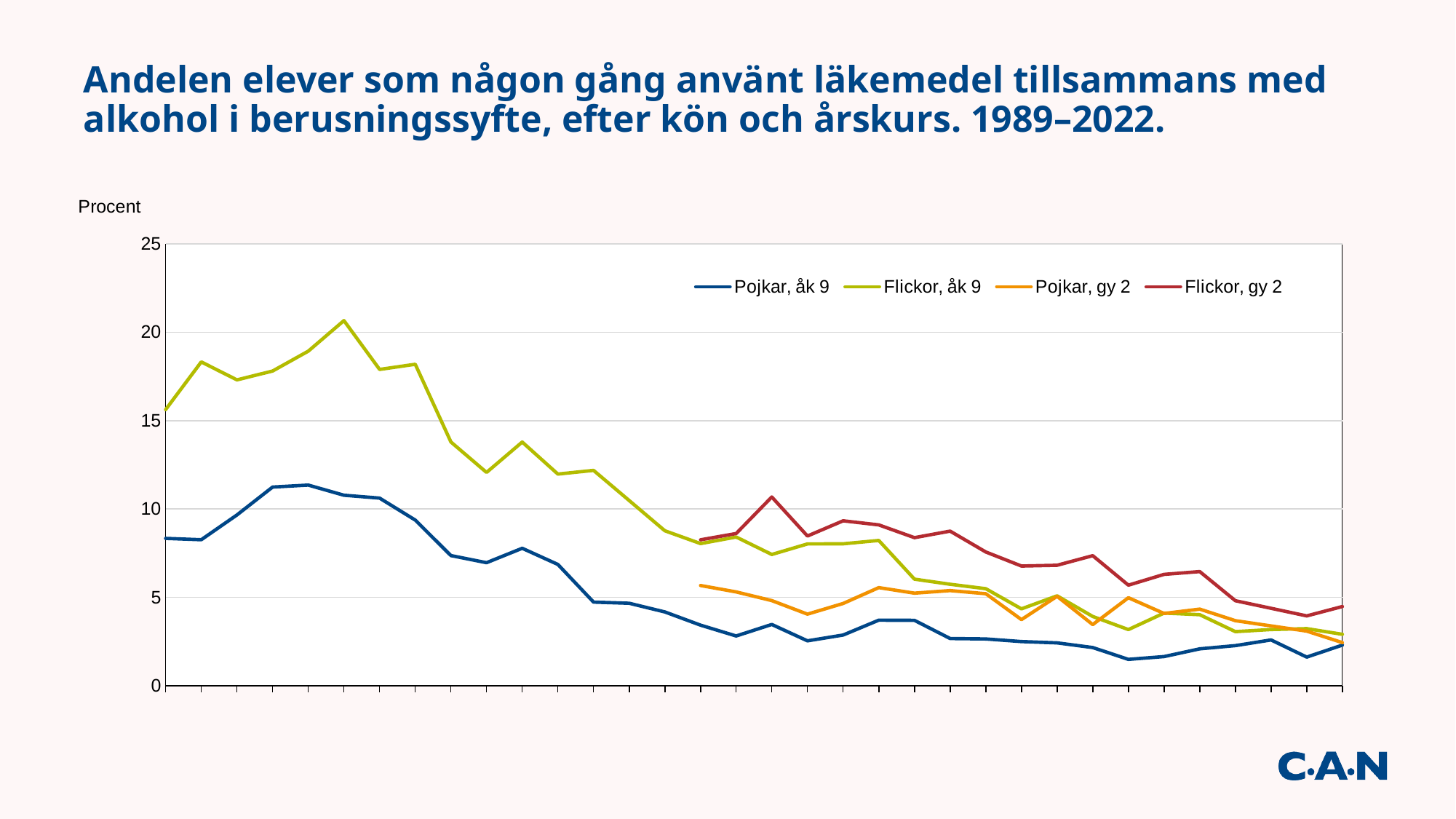
Is the last value of the Pojkar, åk 9 series greater or less than 5? less Which series reaches the highest value anywhere on the chart? Flickor, åk 9 What is the label on the vertical axis? Procent At the right end of the chart, which is higher: Flickor, gy 2 or Flickor, åk 9? Flickor, gy 2 What kind of chart is shown on the slide? Line chart How many series does the legend list? 4 Is the highest value of the Flickor, gy 2 series greater or less than 10? greater Is the peak value of the Pojkar, åk 9 series greater or less than 15? less Overall, does the Flickor, åk 9 series rise or fall from left to right? Fall At the left end of the chart, which is higher: Flickor, åk 9 or Pojkar, åk 9? Flickor, åk 9 Which series does the legend list first? Pojkar, åk 9